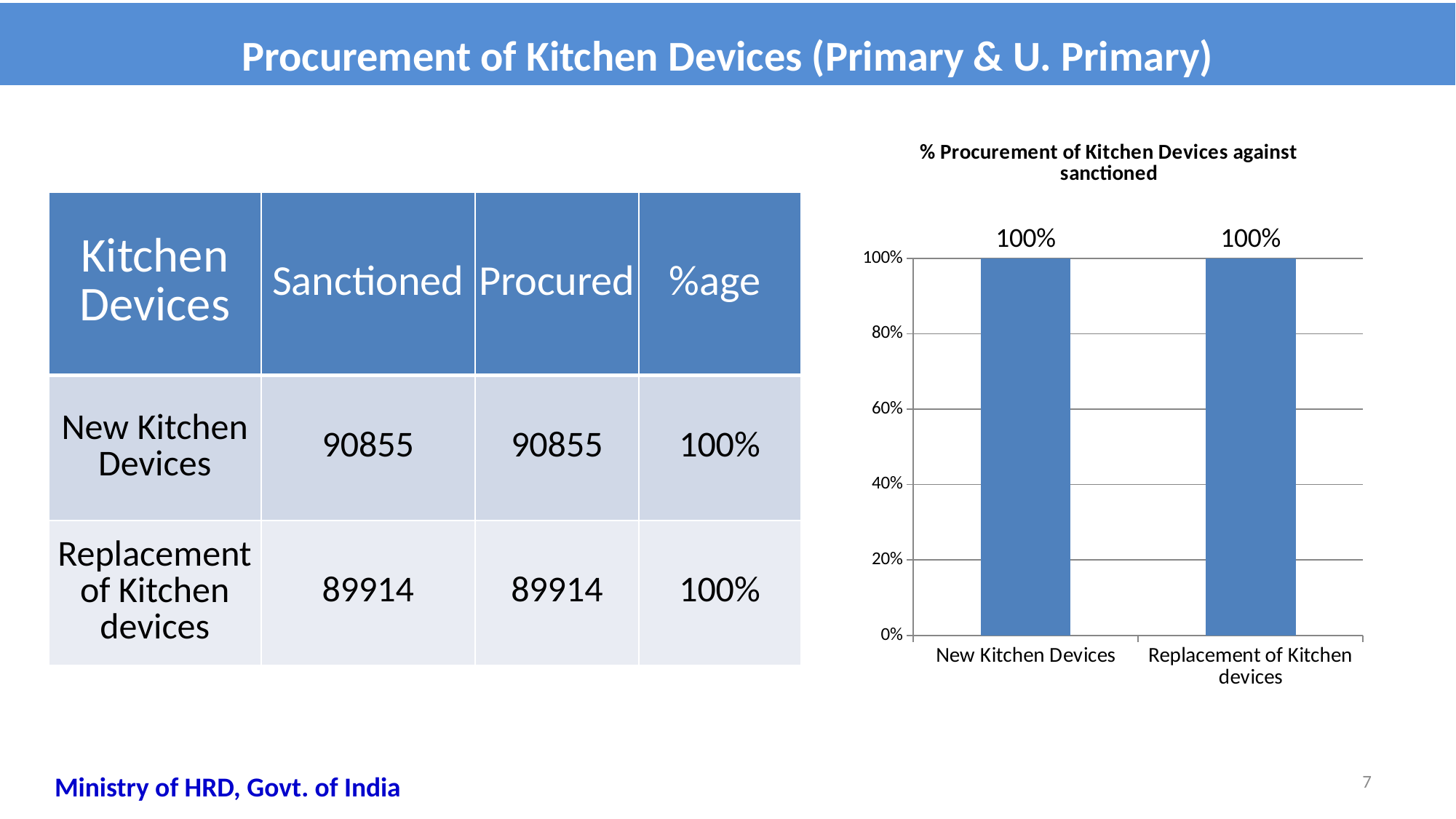
What is the title of the chart? % Procurement of Kitchen Devices against sanctioned Is the value for New Kitchen Devices greater or less than 80%? greater What is the value for Replacement of Kitchen devices in the chart? 100% What is the difference between the values for New Kitchen Devices and Replacement of Kitchen devices in the chart? 0% How many categories are shown on the x axis of the chart? 2 What is the value for New Kitchen Devices in the chart? 100% Is the value for Replacement of Kitchen devices greater or less than 60%? greater Do the values rise, fall or stay the same from New Kitchen Devices to Replacement of Kitchen devices? Stay the same What is the highest value shown on the chart's y axis? 100% What kind of chart is shown on the slide? Bar chart